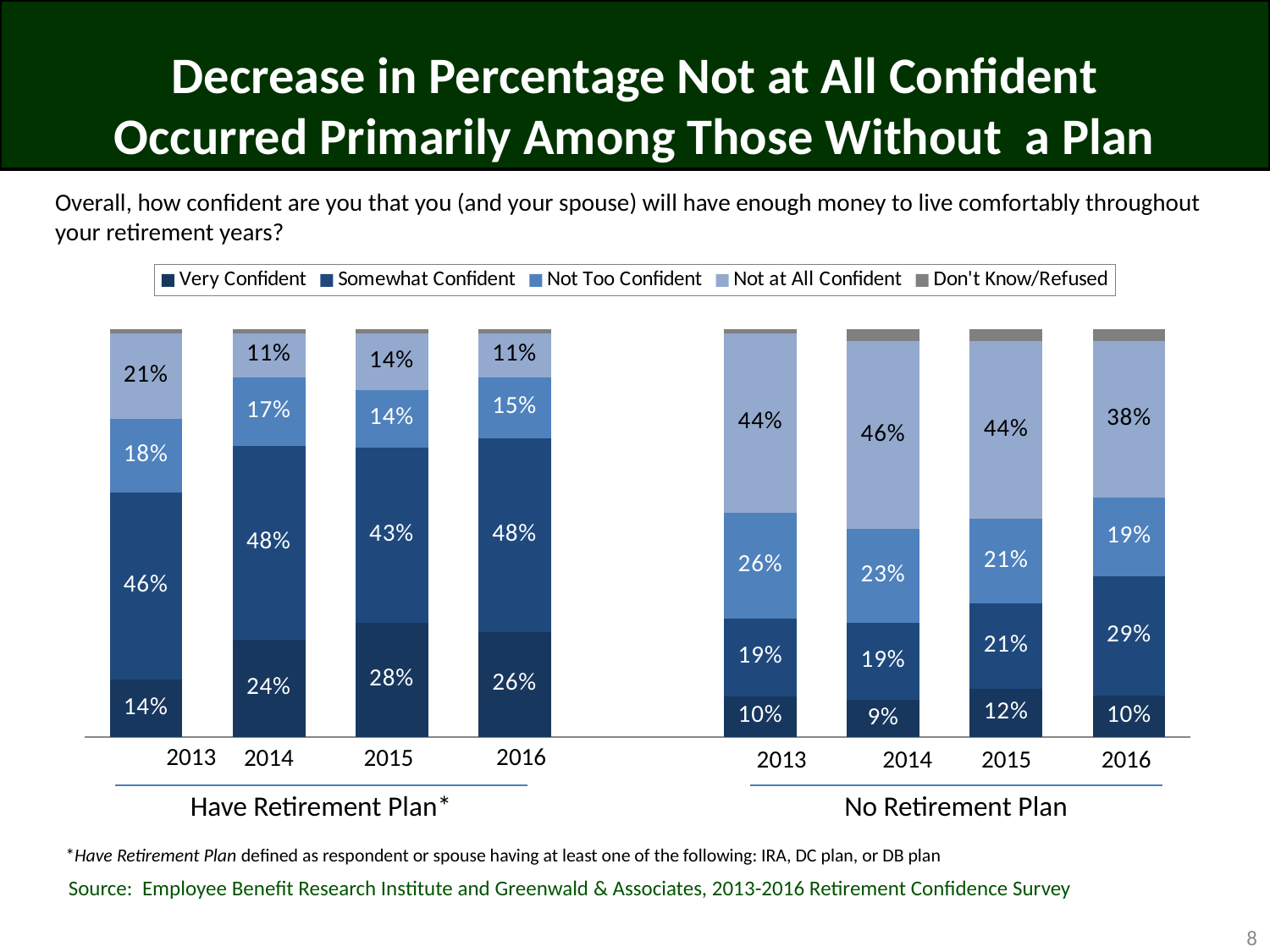
What kind of chart is used on this slide? Stacked bar chart How many years are shown in each chart? 4 In the Have Retirement Plan chart, what is the difference between the Not at All Confident percentage in 2013 and in 2016? 10 percentage points In the No Retirement Plan chart, what percentage were Somewhat Confident in 2016? 29% In the Have Retirement Plan chart, what percentage were Very Confident in 2013? 14% In the No Retirement Plan chart, what is the difference between the Not at All Confident percentage in 2014 and in 2016? 8 percentage points In the No Retirement Plan chart, what percentage were Not at All Confident in 2016? 38% In the Have Retirement Plan chart, which year has the highest Very Confident percentage? 2015 In the No Retirement Plan chart, which year has the lowest Very Confident percentage? 2014 In the No Retirement Plan chart, does the Somewhat Confident percentage rise or fall from 2015 to 2016? Rise Which is larger: the Somewhat Confident percentage in 2015 for those with a retirement plan, or for those without a retirement plan? Have Retirement Plan (43% vs 21%) How many series does the legend list? 5